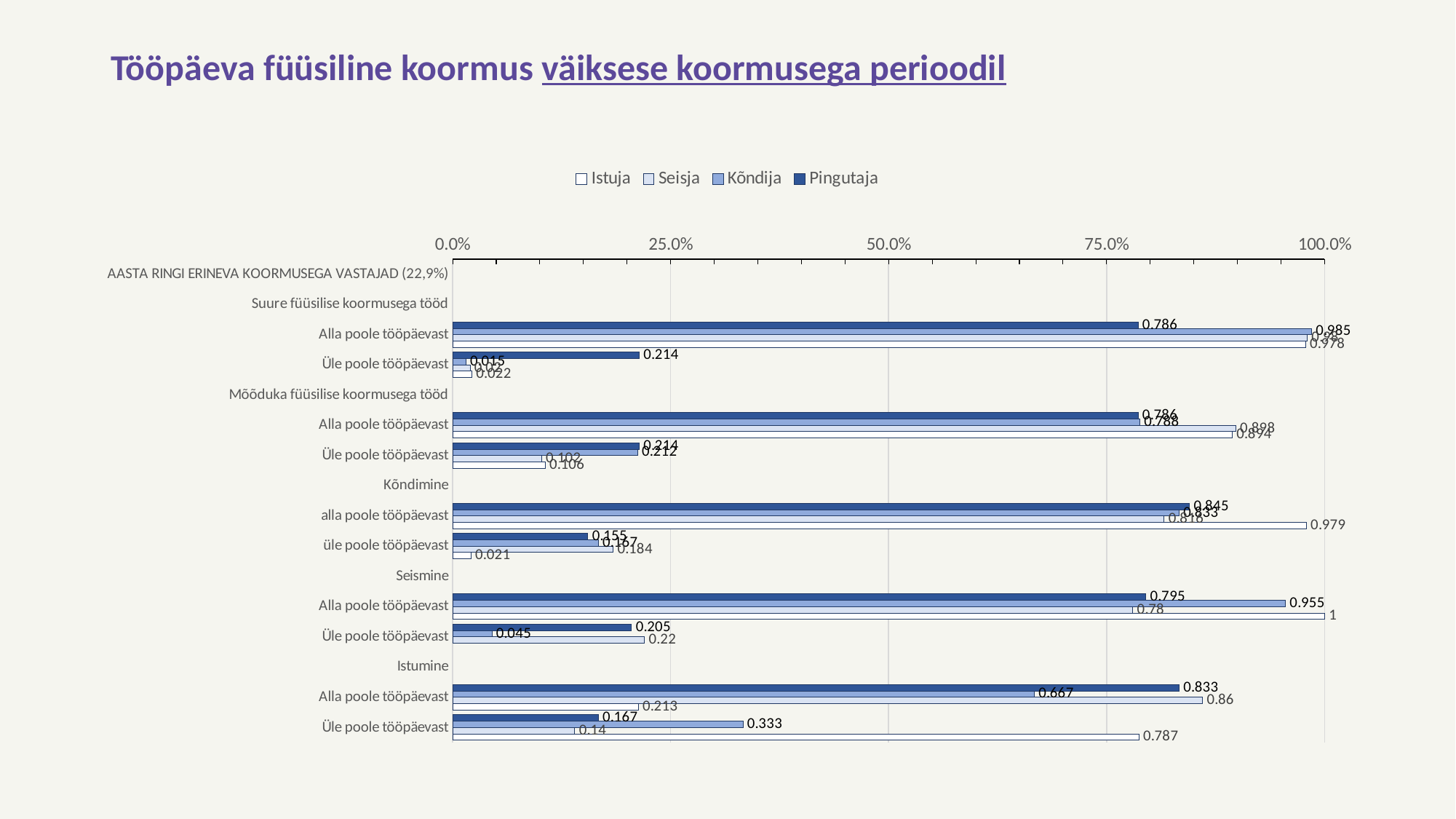
What kind of chart is shown on the slide? bar chart Under 'Seismine', 'Alla poole tööpäevast', which series has the highest value? Istuja Under 'Istumine', 'Üle poole tööpäevast', what is the difference between the Kõndija value (0.333) and the Pingutaja value (0.167)? 0.166 Under 'Istumine', 'Alla poole tööpäevast', which is larger: the Pingutaja value or the Kõndija value? Pingutaja What is the Kõndija value for 'Alla poole tööpäevast' under 'Suure füüsilise koormusega tööd'? 0.985 What is the Istuja value for 'Üle poole tööpäevast' under 'Istumine'? 0.787 What is the Pingutaja value for 'Üle poole tööpäevast' under 'Suure füüsilise koormusega tööd'? 0.214 How many series does the legend list? 4 What is the Kõndija value for 'Alla poole tööpäevast' under 'Seismine'? 0.955 What is the Pingutaja value for 'Alla poole tööpäevast' under 'Suure füüsilise koormusega tööd'? 0.786 What is the Istuja value for 'alla poole tööpäevast' under 'Kõndimine'? 0.979 Is the Istuja value for 'Üle poole tööpäevast' under 'Istumine' greater or less than 75.0%? greater